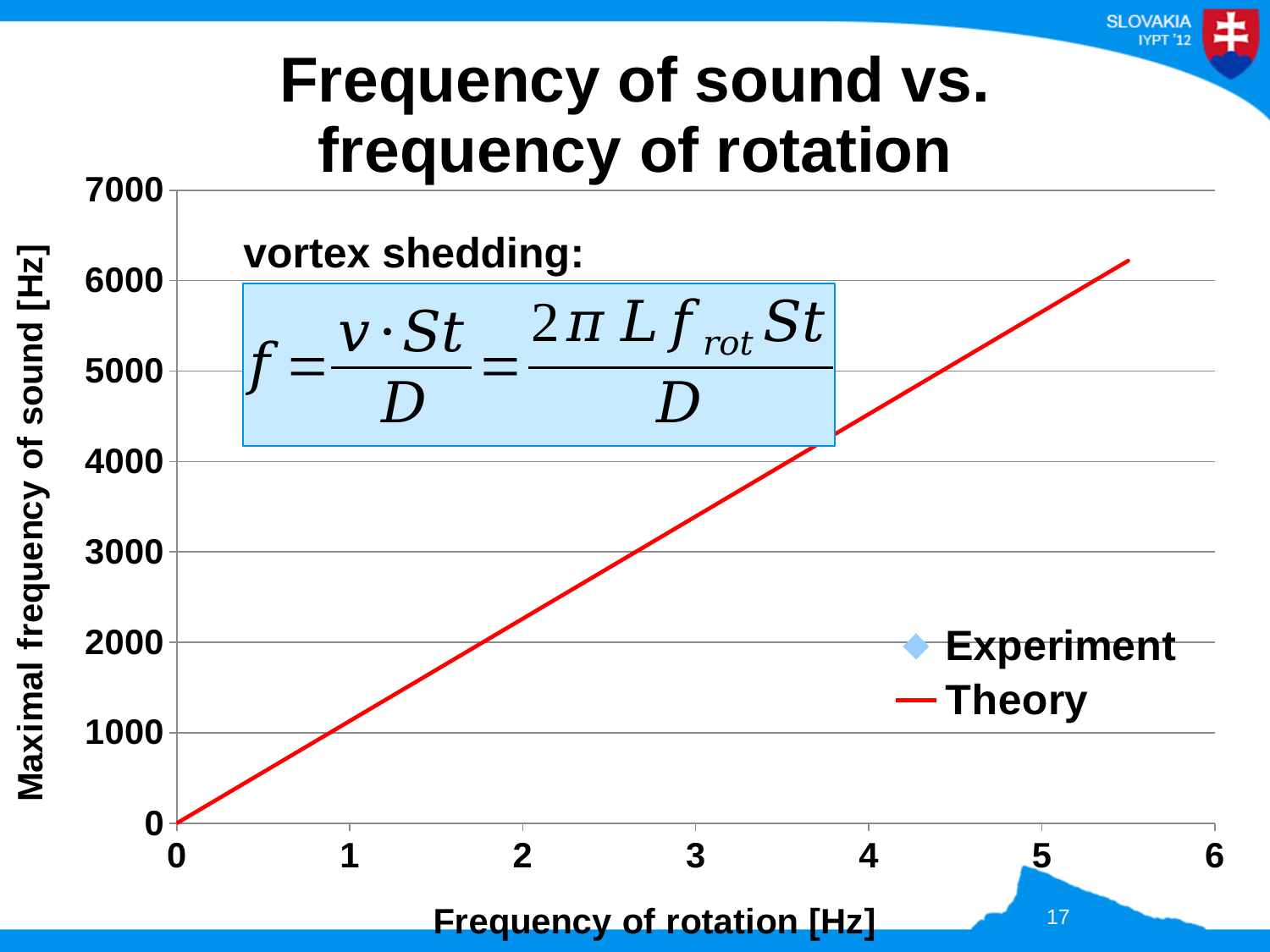
What is the title of the chart? Frequency of sound vs. frequency of rotation Is the Theory value at a frequency of rotation of 3 Hz greater or less than 3000? greater Is the Theory value at a frequency of rotation of 4 Hz greater or less than 5000? less How many series does the legend list? 2 Does the Theory line rise or fall as the frequency of rotation increases? rises Is the Theory value at a frequency of rotation of 2 Hz greater or less than 3000? less What kind of chart is shown on the slide? line chart What is the label of the y axis? Maximal frequency of sound [Hz]